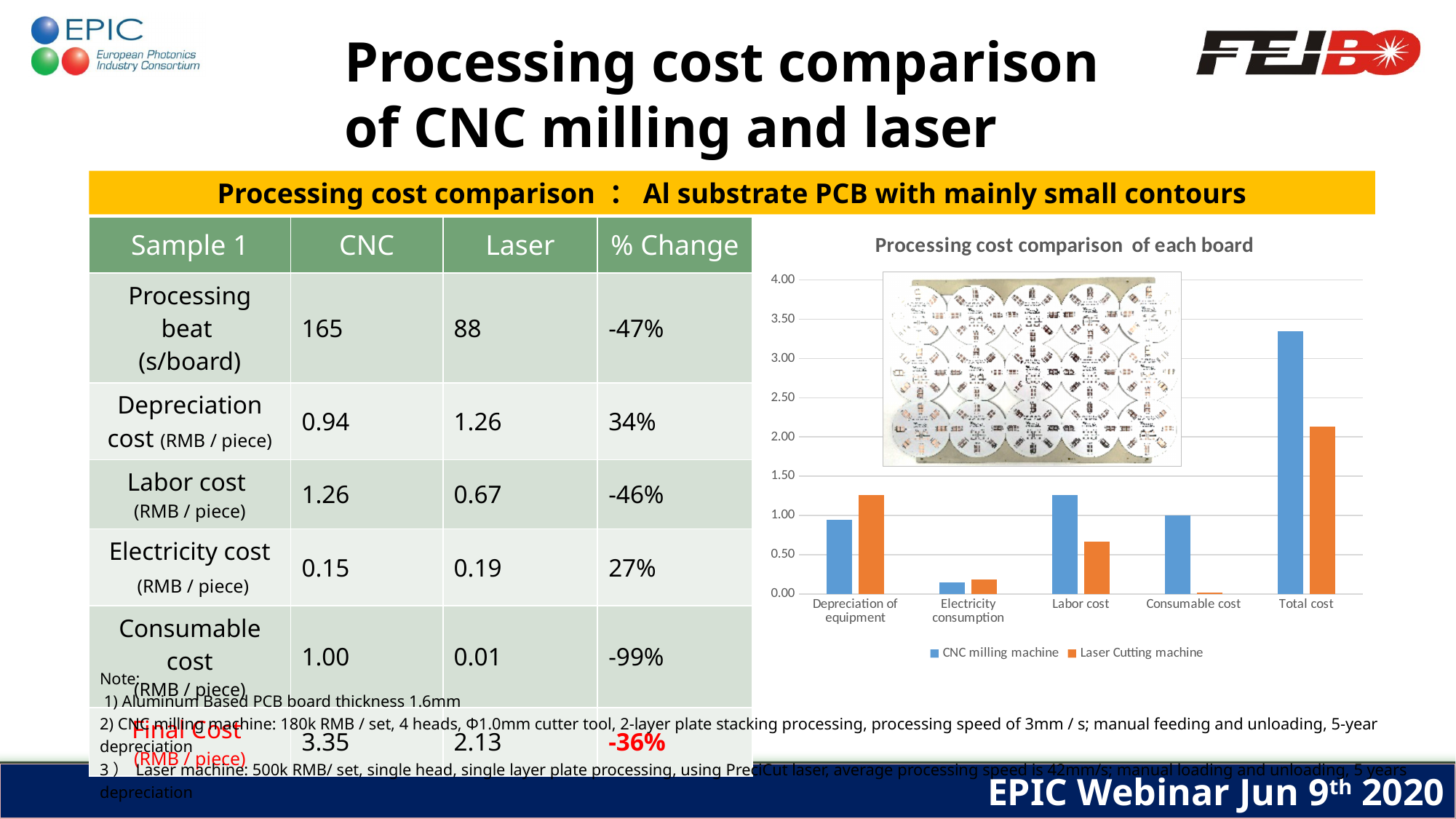
Which category has the highest value for the CNC milling machine series? Total cost What colour are the bars for the Laser Cutting machine series? Orange For Labor cost, which series has the larger value, CNC milling machine or Laser Cutting machine? CNC milling machine What type of chart is shown on the slide? Bar chart What is the title of the chart? Processing cost comparison of each board Which category has the lowest value for the Laser Cutting machine series? Consumable cost Is the Total cost value for the Laser Cutting machine greater or less than 2.50? less Is the Total cost value for the CNC milling machine greater or less than 3.00? greater Is the Consumable cost value for the CNC milling machine greater or less than 0.50? greater How many cost categories are shown on the x axis of the chart? 5 How many series does the chart legend list? 2 For Depreciation of equipment, which series has the larger value, CNC milling machine or Laser Cutting machine? Laser Cutting machine